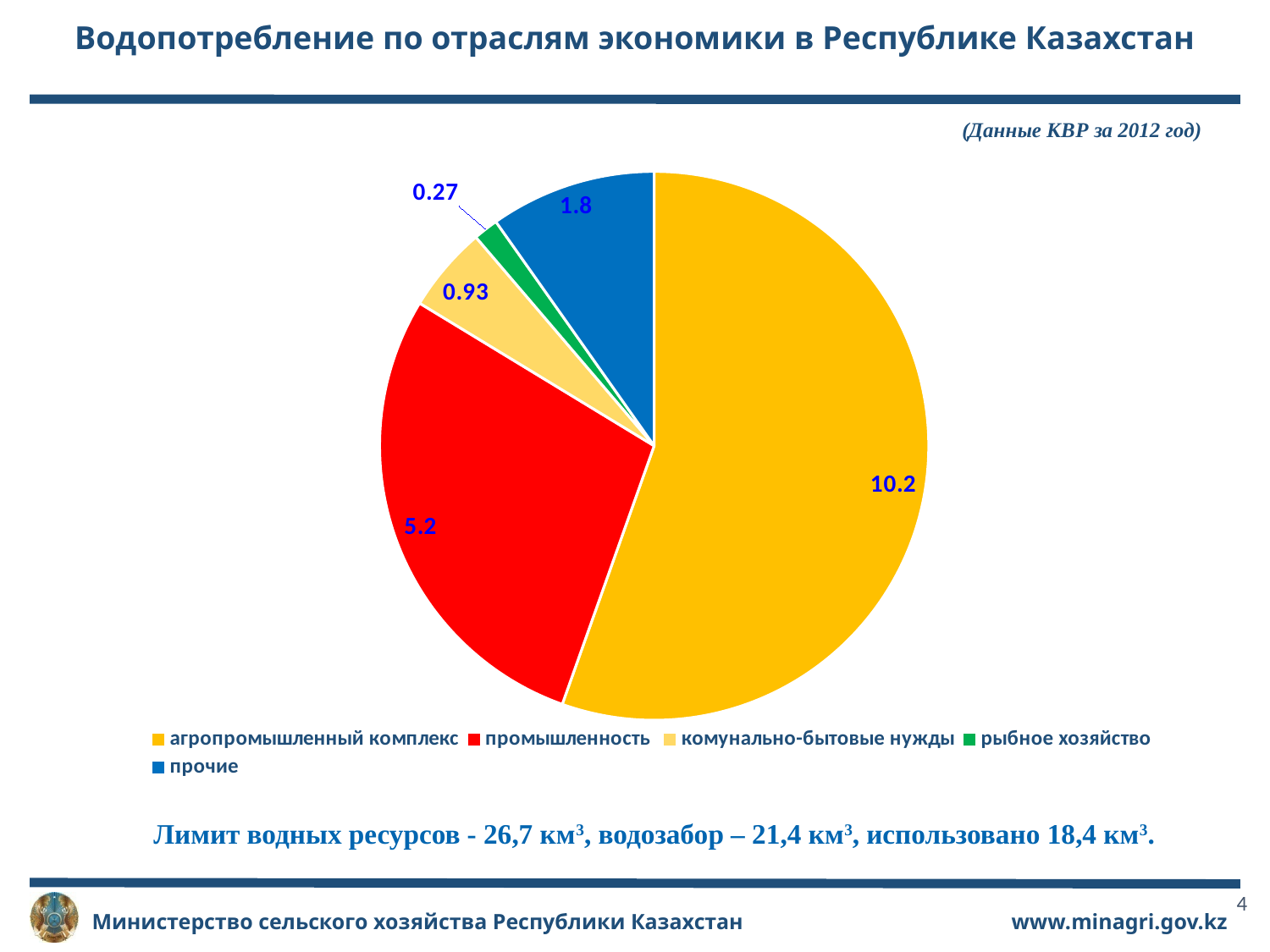
What type of chart is shown on the slide? pie chart What is the value for комунально-бытовые нужды? 0.93 What is the value for агропромышленный комплекс? 10.2 What is the value for прочие? 1.8 What is the value for рыбное хозяйство? 0.27 Which is larger, the value for прочие or the value for комунально-бытовые нужды? прочие What is the difference between the values for агропромышленный комплекс and промышленность? 5 What is the value for промышленность? 5.2 Which category has the smallest slice of the pie? рыбное хозяйство What colour is the slice for промышленность? red Which category has the largest slice of the pie? агропромышленный комплекс How many categories does the pie chart have? 5